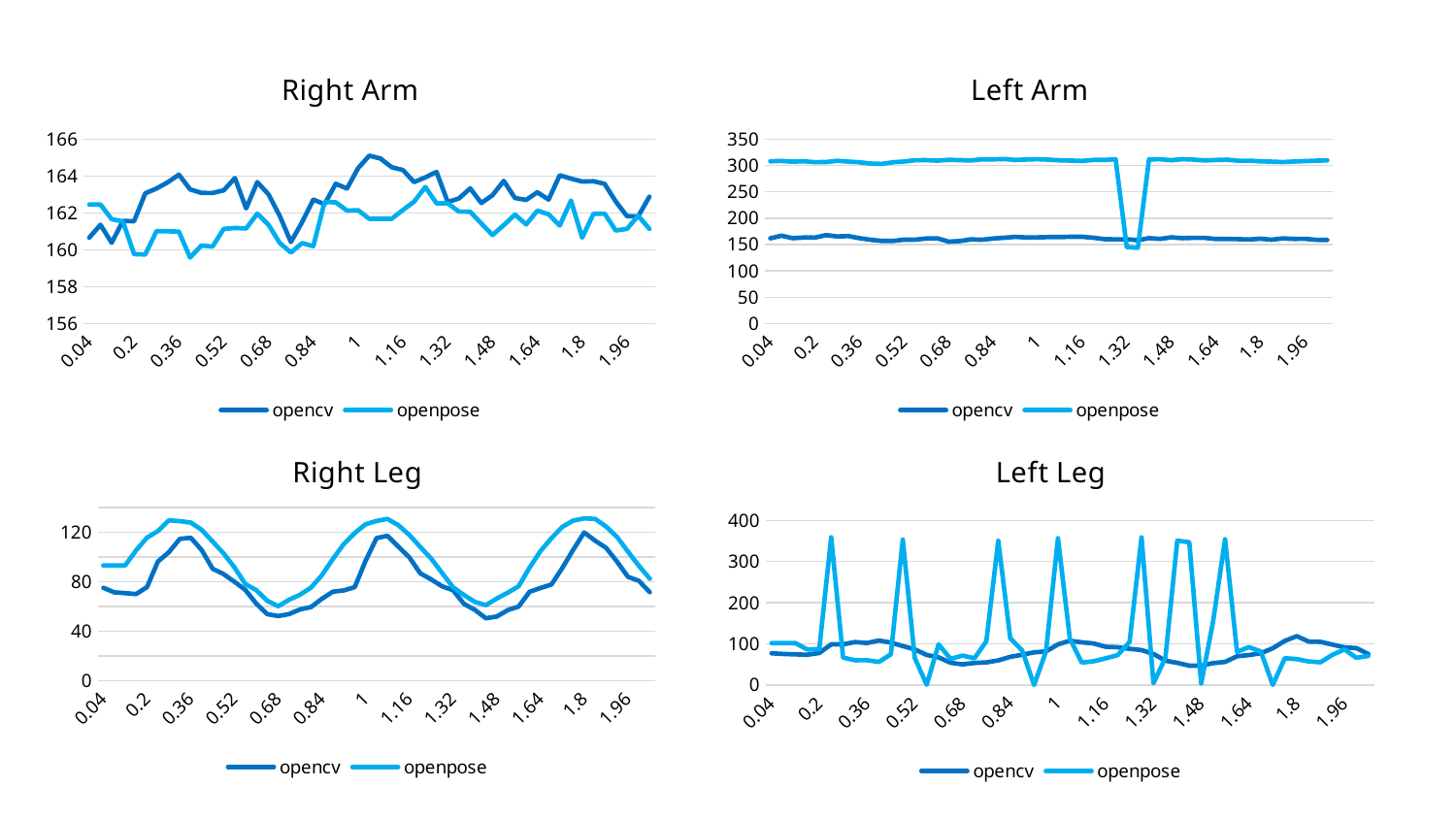
In the Left Arm chart, is the opencv value at 0.04 greater or less than 200? less How many series does the legend of the Left Arm chart list? 2 What are the legend entries of the Right Leg chart? opencv, openpose In the Left Leg chart, is the highest openpose value greater or less than 300? greater In the Right Leg chart, is the openpose value at 0.36 greater or less than 120? greater What kind of chart is the Right Arm chart? line chart In the Left Arm chart, which series is higher at 0.2, opencv or openpose? openpose How many charts are shown on the slide? 4 What are the titles of the four charts on the slide? Right Arm, Left Arm, Right Leg, Left Leg